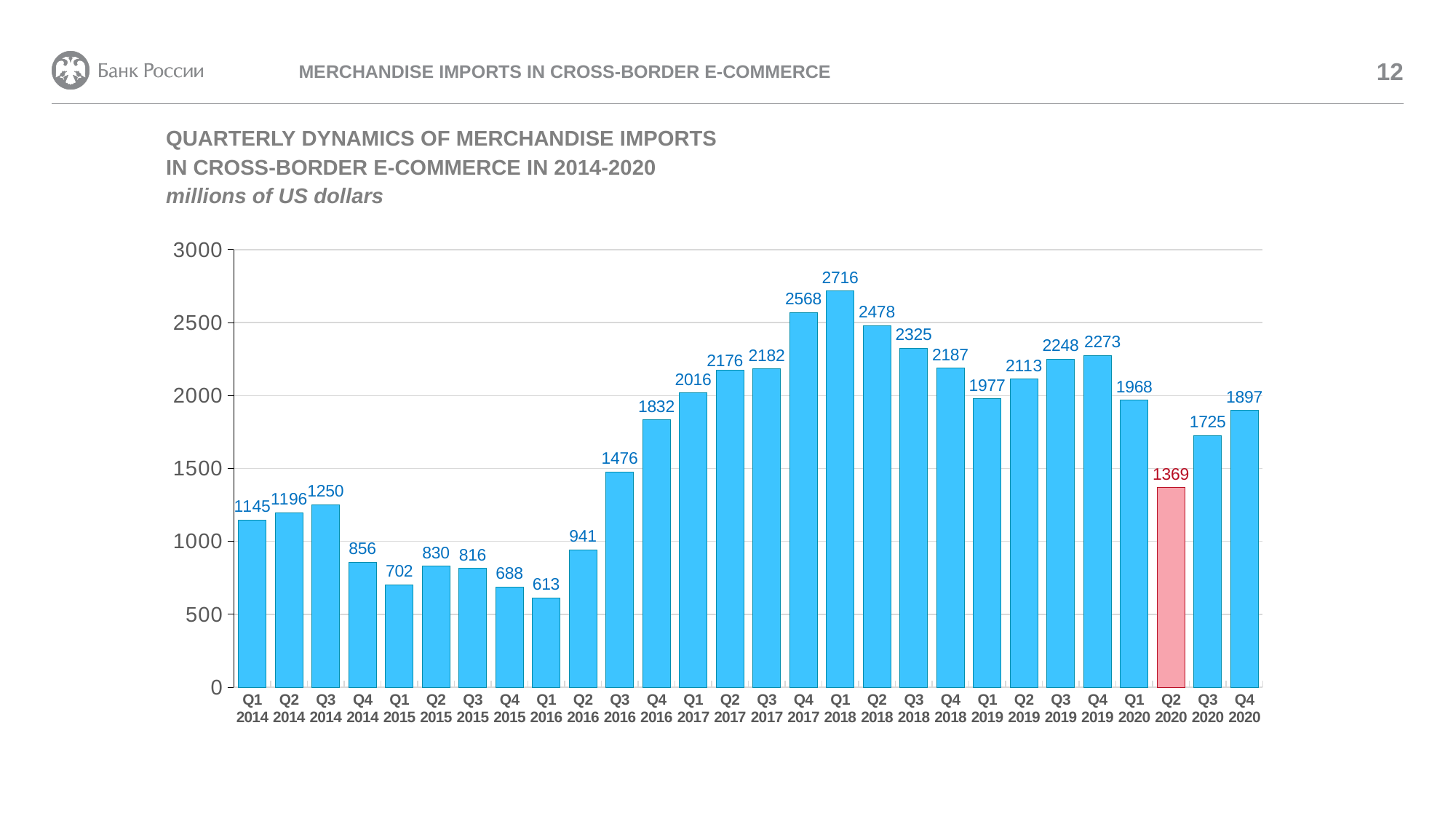
Which quarter has the lowest value of merchandise imports? Q1 2016 Which bar is coloured differently (red) from the rest? Q2 2020 Which is larger, the value for Q3 2020 or the value for Q4 2020? Q4 2020 Is the value for Q4 2017 greater or less than 2500? greater In what units are the values in the chart expressed? millions of US dollars What is the value of merchandise imports in cross-border e-commerce for Q1 2018? 2716 Do the values rise or fall from Q1 2017 to Q1 2018? rise What is the difference between the values for Q4 2019 and Q1 2020? 305 Which quarter has the highest value of merchandise imports? Q1 2018 What type of chart is shown on the slide? bar chart How many quarterly bars are plotted in the chart? 28 What is the value shown for Q2 2020, the bar highlighted in red? 1369